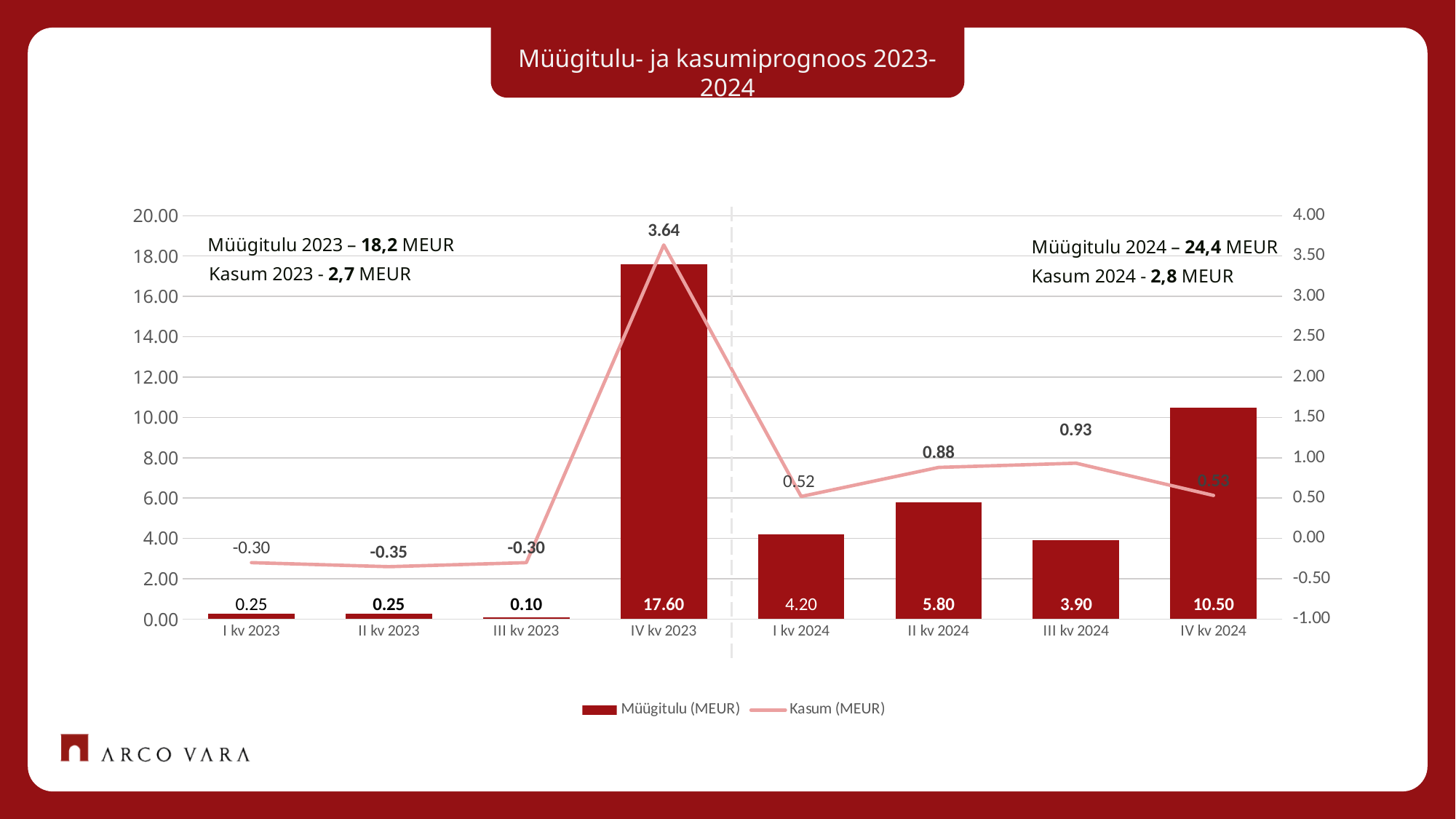
How many series does the legend list? 2 Which is larger, the Müügitulu (MEUR) for II kv 2024 or for III kv 2024? II kv 2024 Which quarter has the highest Müügitulu (MEUR)? IV kv 2023 What is the Kasum (MEUR) value for III kv 2024? 0.93 What is the title of the slide? Müügitulu- ja kasumiprognoos 2023-2024 How many quarters are shown on the x axis? 8 Which quarter has the lowest Müügitulu (MEUR)? III kv 2023 Which quarter has the lowest Kasum (MEUR)? II kv 2023 What is the Müügitulu (MEUR) value for IV kv 2023? 17.60 What is the Kasum (MEUR) value for II kv 2023? -0.35 What is the difference in Müügitulu (MEUR) between IV kv 2024 and I kv 2024? 6.30 What kind of chart is shown on the slide? Combined bar and line chart